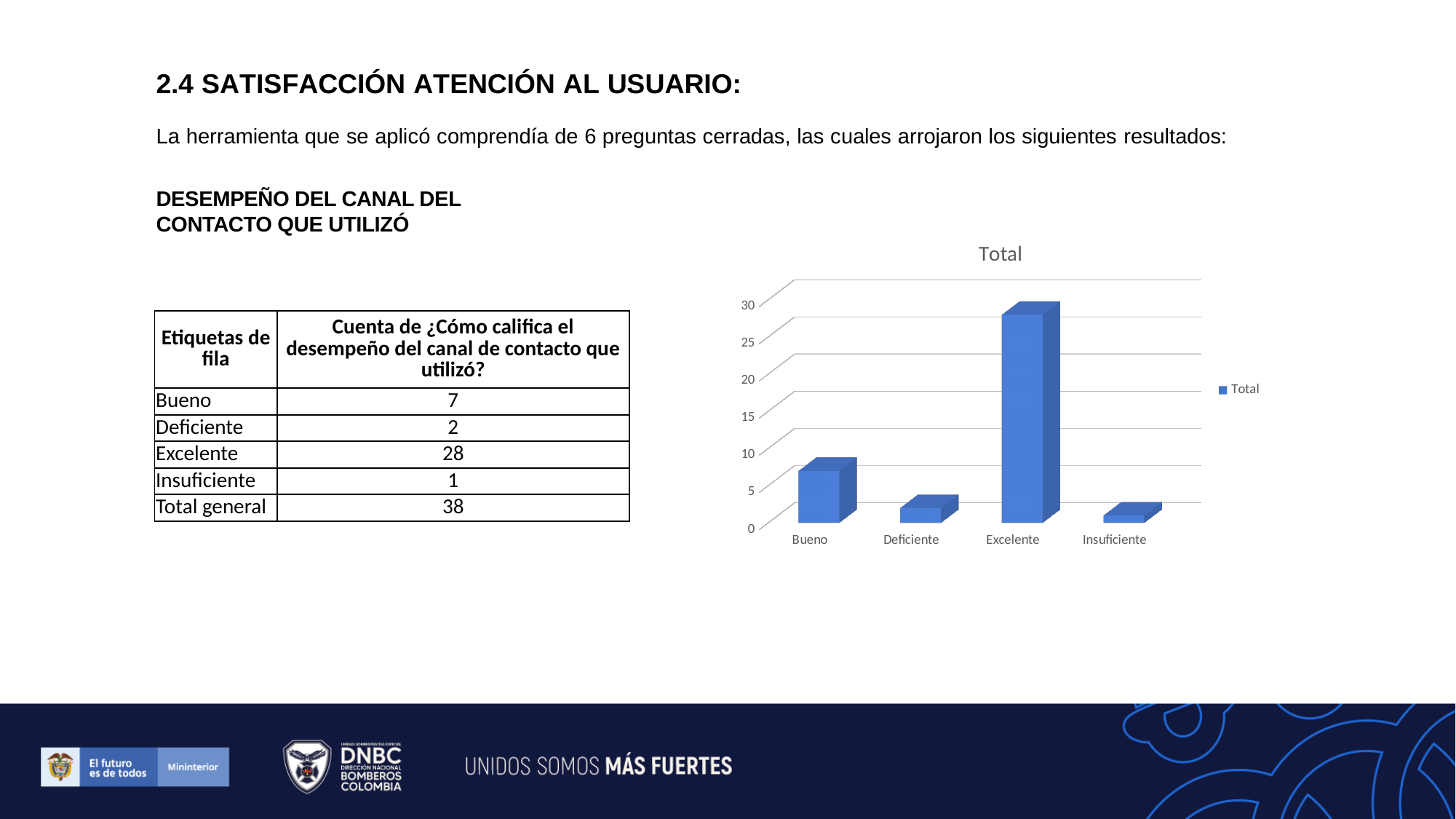
Which is larger, the value for Bueno or the value for Deficiente? Bueno How many categories are shown on the x axis of the chart? 4 Which category has the highest bar in the chart? Excelente Is the value for Bueno greater or less than 10? less Using the values in the table, what is the difference between Excelente and Bueno? 21 What is the title of the chart? Total According to the table on the slide, what is the value for Deficiente? 2 How many series does the chart legend list? 1 Is the value for Excelente greater or less than 25? greater Which category has the lowest bar in the chart? Insuficiente According to the table on the slide, what is the value for Excelente? 28 What kind of chart is shown on the slide? bar chart